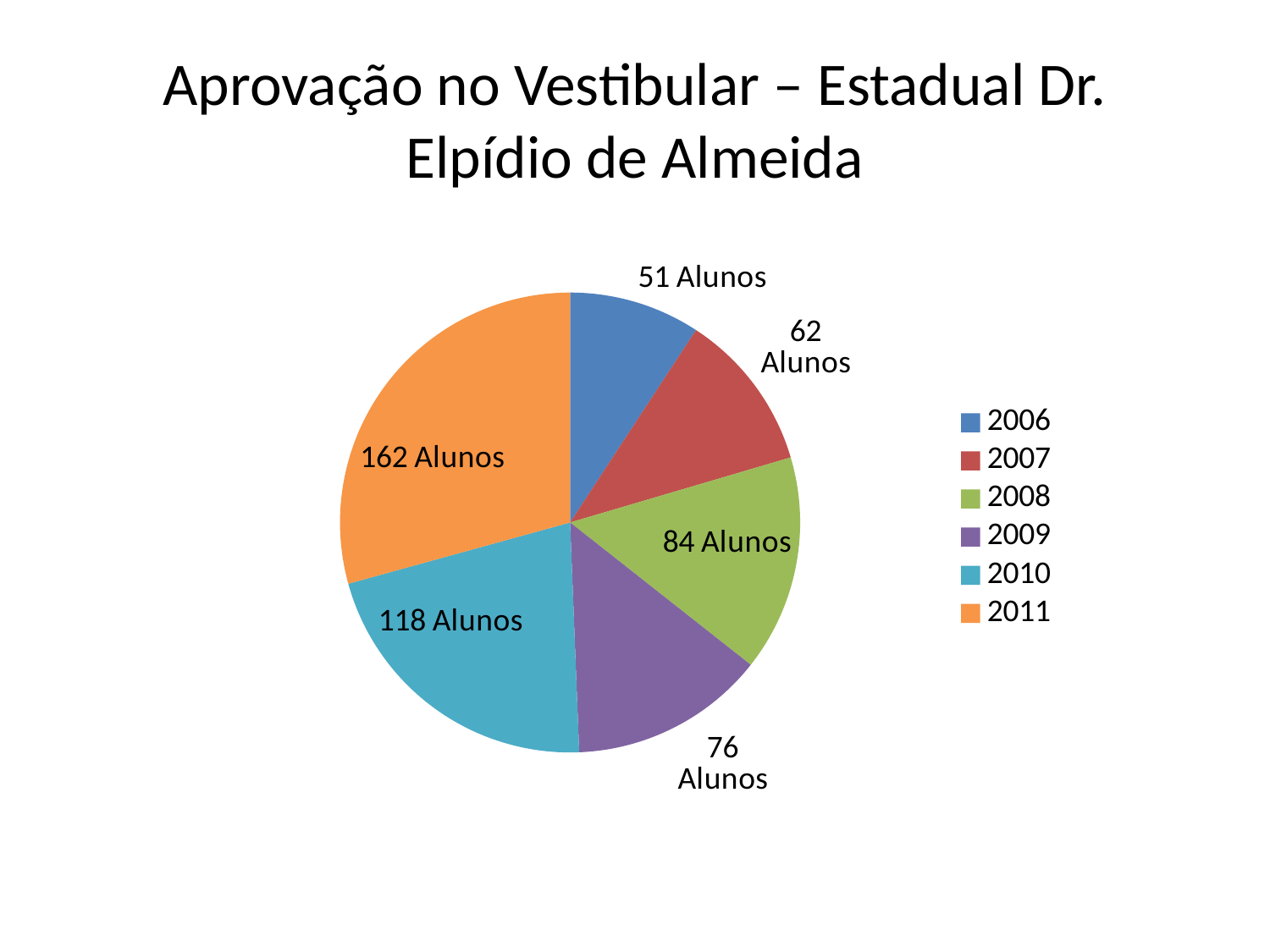
What is the difference between the number of students in 2011 and in 2010? 44 How many students were approved in 2008? 84 Alunos Which year had more approved students, 2007 or 2009? 2009 Which year has the smallest slice of the pie? 2006 How many years (slices) does the pie chart show? 6 What kind of chart is shown on the slide? Pie chart How many students were approved in 2006? 51 Alunos What is the total number of students across all slices of the pie? 553 How many students were approved in 2011? 162 Alunos How many students were approved in 2010? 118 Alunos Which year has the largest slice of the pie? 2011 What is the difference between the number of students in 2008 and in 2009? 8